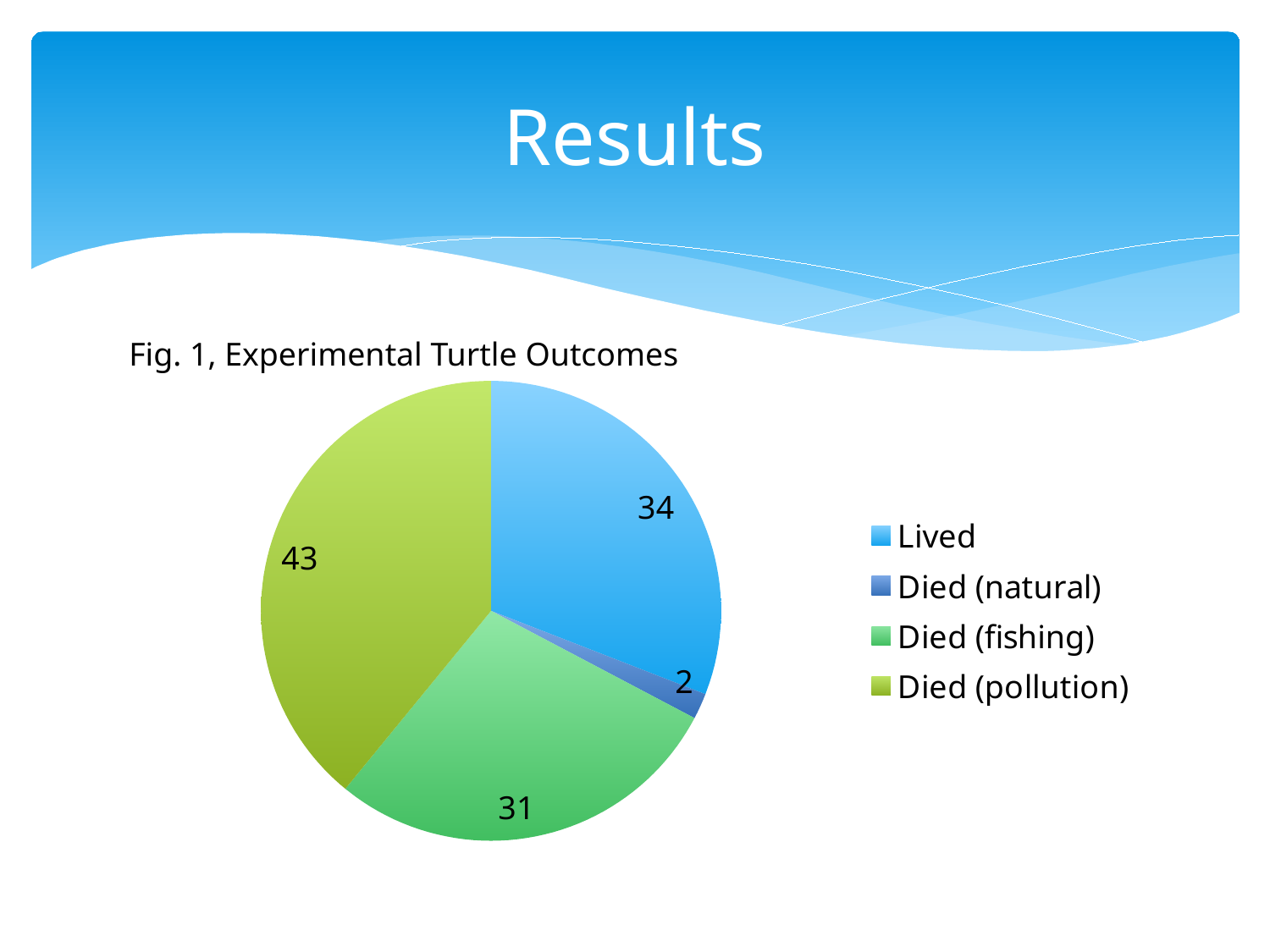
What is the difference between the values for Died (pollution) and Lived? 9 Which is larger, the value for Lived or the value for Died (fishing)? Lived Which category has the largest slice? Died (pollution) What is the value for Lived? 34 How many categories does the pie chart have? 4 What is the value for Died (natural)? 2 What is the value for Died (fishing)? 31 What is the value for Died (pollution)? 43 Which category has the smallest slice? Died (natural) What kind of chart is shown on the slide? pie chart What is the title of the chart? Fig. 1, Experimental Turtle Outcomes What share of the pie does the Died (pollution) slice represent? 39.1%